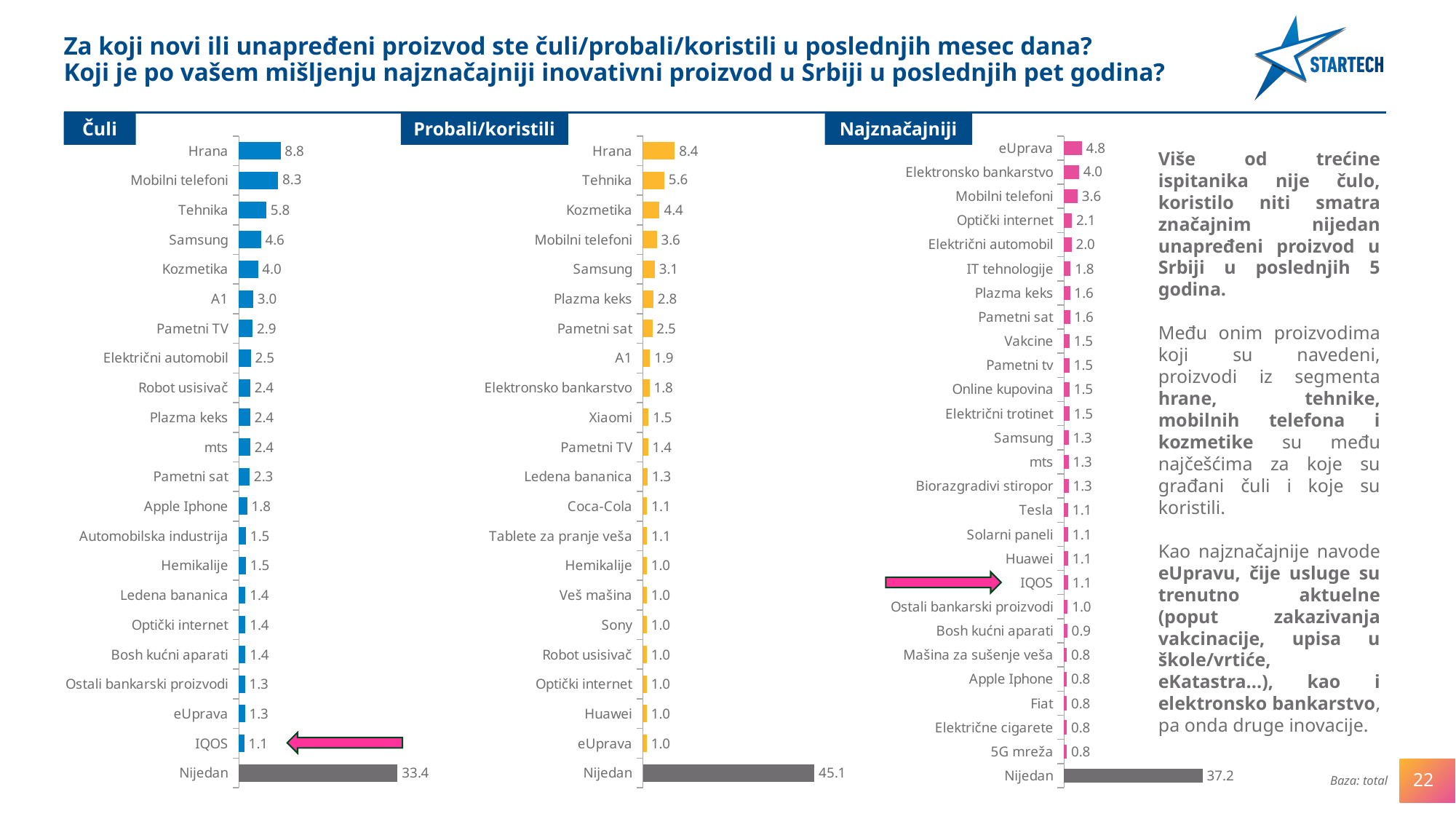
In the 'Najznačajniji' chart, what is the value for eUprava? 4.8 In the 'Čuli' chart, which category has the highest value? Nijedan In the 'Probali/koristili' chart, which is larger, the value for Tehnika or the value for Mobilni telefoni? Tehnika How many categories are shown in the 'Najznačajniji' chart? 27 In the 'Čuli' chart, what is the difference between the values for Hrana and Mobilni telefoni? 0.5 In the 'Najznačajniji' chart, what is the difference between the values for Nijedan and eUprava? 32.4 In the 'Najznačajniji' chart, what is the value for Nijedan? 37.2 How many categories are shown in the 'Čuli' chart? 22 In the 'Probali/koristili' chart, what is the value for Kozmetika? 4.4 What type of chart is the 'Probali/koristili' chart? Bar chart In the 'Čuli' chart, what is the value for Hrana? 8.8